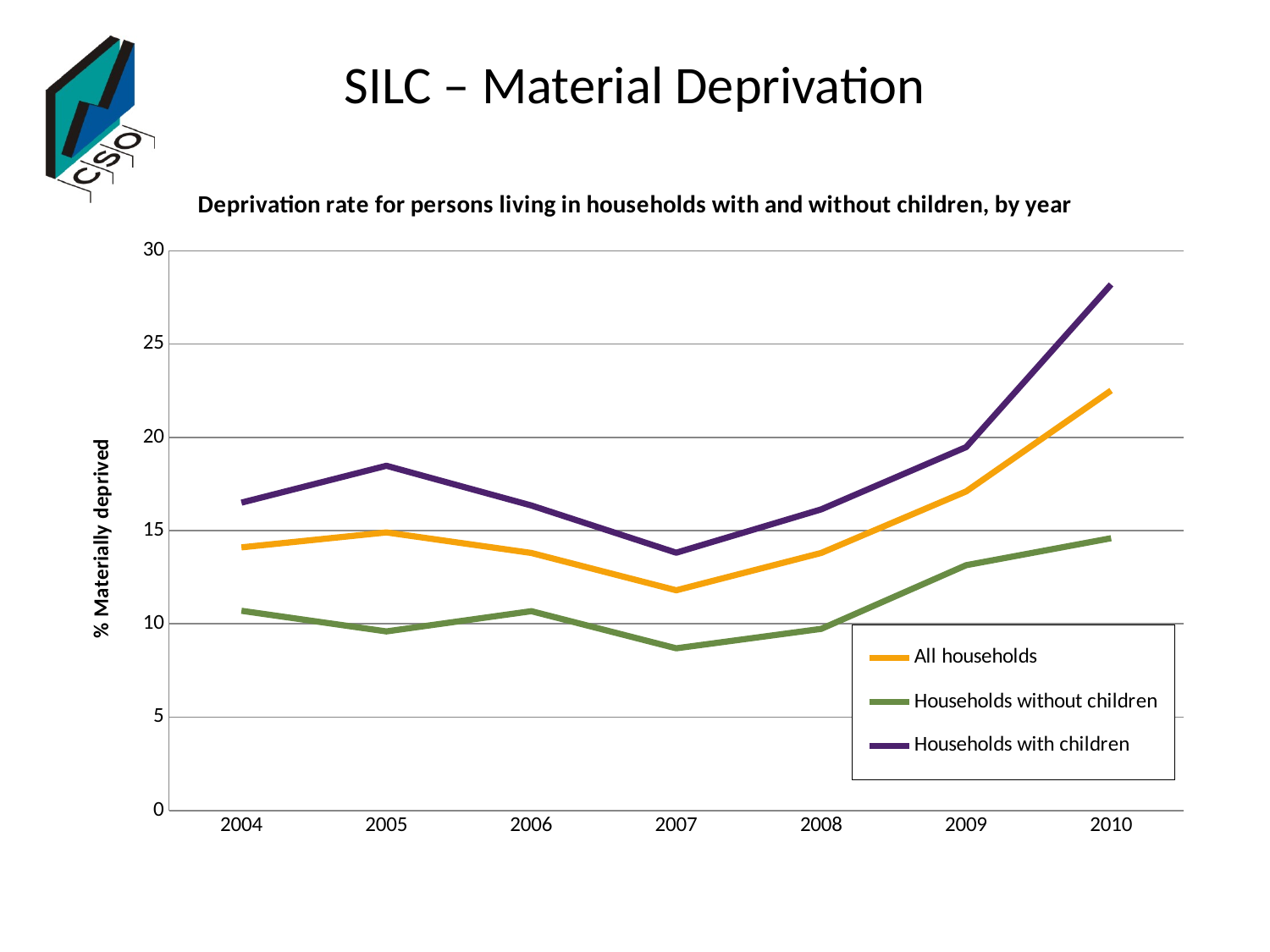
In 2010, which is larger: the deprivation rate for households with children or for households without children? Households with children How many series does the legend list? 3 In which year is the deprivation rate for households with children highest? 2010 What is the title of the chart? Deprivation rate for persons living in households with and without children, by year What is the label on the y axis? % Materially deprived In which year is the deprivation rate for all households lowest? 2007 Is the value for households without children in 2007 greater or less than 10? less Between 2007 and 2010, does the deprivation rate for all households rise or fall? Rise How many years are shown on the x axis? 7 What kind of chart is shown on the slide? Line chart Is the value for households with children in 2010 greater or less than 25? greater Is the value for all households in 2009 greater or less than 15? greater